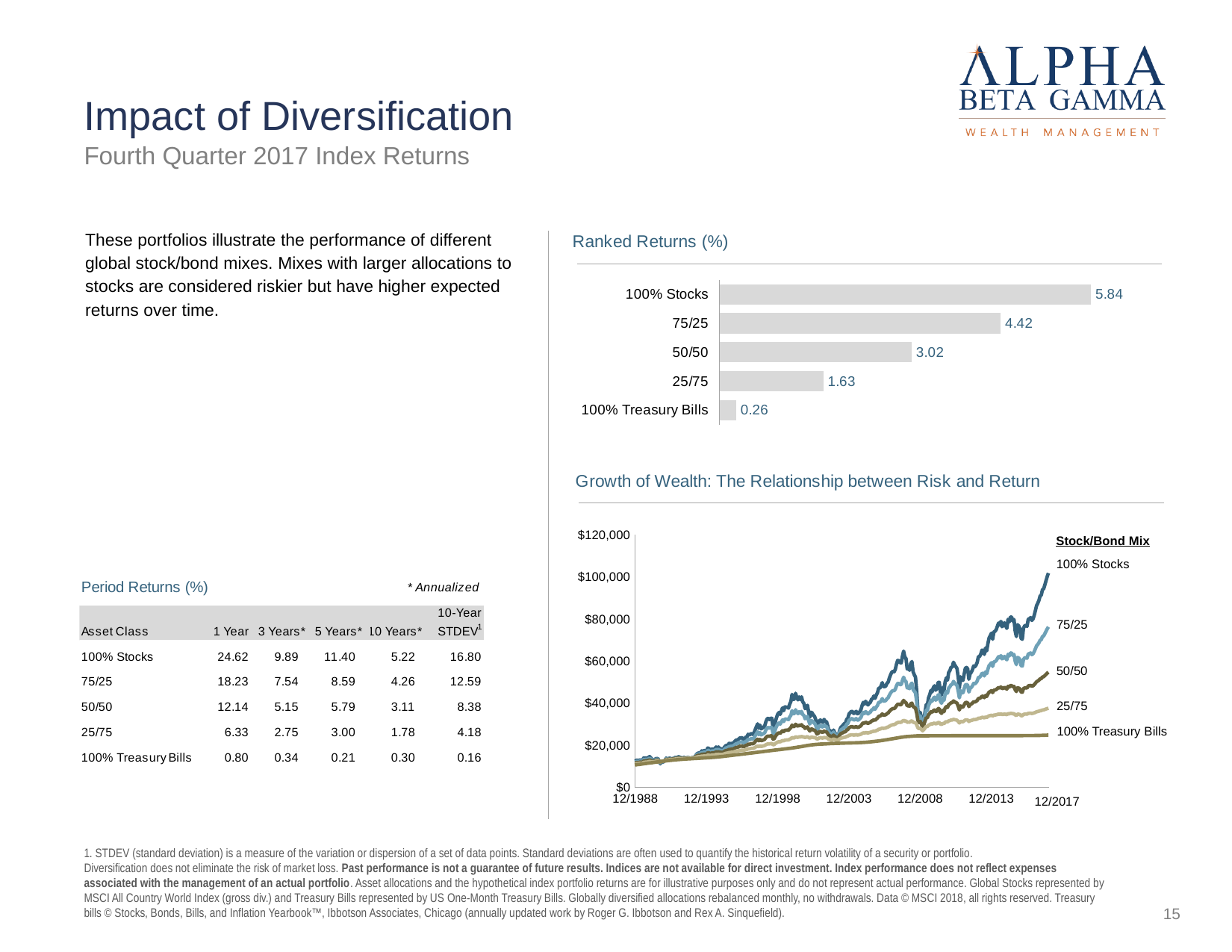
In the Ranked Returns (%) chart, what is the value for 100% Treasury Bills? 0.26 In the Ranked Returns (%) chart, which category has the lowest value? 100% Treasury Bills In the Ranked Returns (%) chart, what is the value for 100% Stocks? 5.84 What kind of chart is the Ranked Returns (%) chart? Bar chart In the Growth of Wealth chart, is the value for 100% Stocks at 12/2017 greater or less than $80,000? greater In the Ranked Returns (%) chart, which category has the highest value? 100% Stocks In the Ranked Returns (%) chart, what is the difference between the values for 75/25 and 50/50? 1.40 How many categories are shown in the Ranked Returns (%) chart? 5 In the Ranked Returns (%) chart, what is the value for 50/50? 3.02 How many series are listed in the Stock/Bond Mix legend of the Growth of Wealth chart? 5 In the Ranked Returns (%) chart, which is larger, the value for 25/75 or the value for 50/50? 50/50 What kind of chart is the Growth of Wealth chart? Line chart